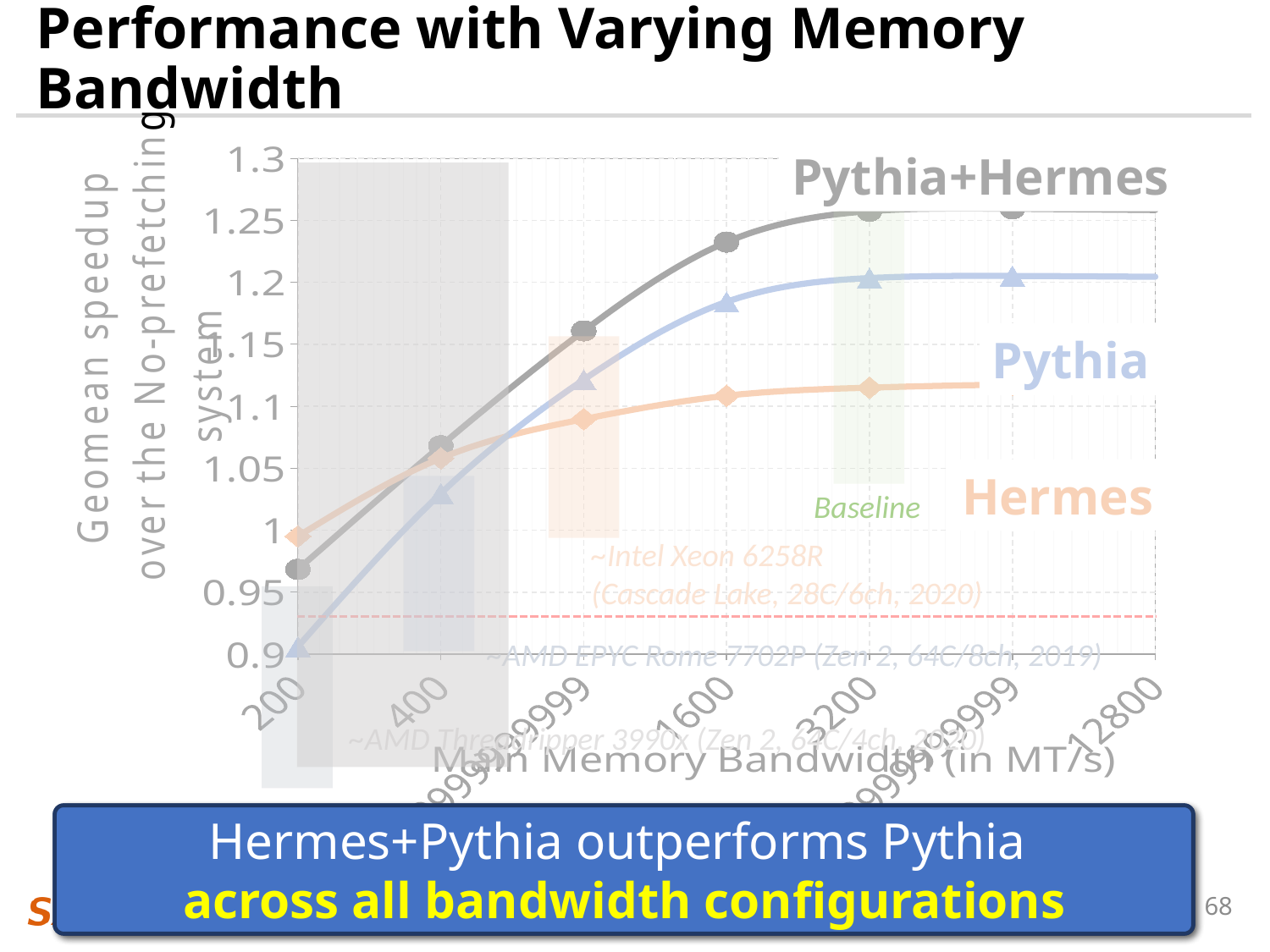
Is the value for Pythia at 200 MT/s greater or less than 0.95? less How many series are plotted on the chart? 3 Which series is drawn with the gray line and circle markers? Pythia+Hermes What is the title of the x axis of the chart? Main Memory Bandwidth (in MT/s) Which series has the highest value at 3200 MT/s? Pythia+Hermes At 1600 MT/s, which is larger: the value for Pythia+Hermes or the value for Hermes? Pythia+Hermes At 200 MT/s, which is larger: the value for Hermes or the value for Pythia? Hermes Do the values for Pythia+Hermes rise or fall as memory bandwidth increases along the x axis? rise Is the value for Pythia at 3200 MT/s greater or less than 1.15? greater Is the value for Pythia+Hermes at 1600 MT/s greater or less than 1.2? greater What kind of chart is shown on the slide? line chart